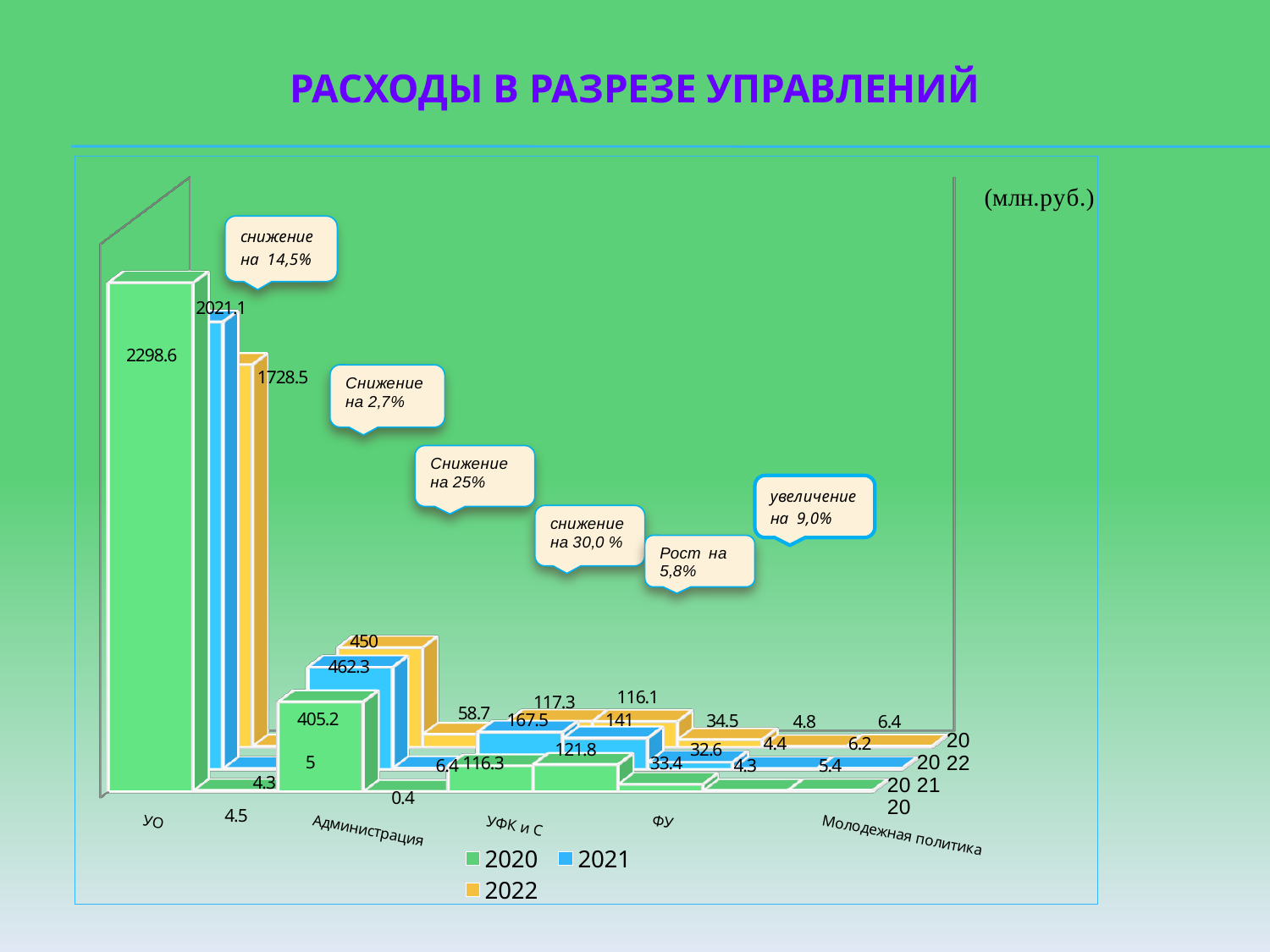
Which is larger for Администрация: the 2020 value or the 2021 value? 2021 What is the value for Администрация in 2022? 450 What is the difference between the УО values for 2020 and 2021? 277.5 What is the title of the chart? РАСХОДЫ В РАЗРЕЗЕ УПРАВЛЕНИЙ What is the value for Администрация in 2021? 462.3 What type of chart is shown on the slide? bar chart How many series does the legend list? 3 Which category has the highest expenses in 2020? УО What is the value for УО in 2020? 2298.6 What is the value for УО in 2022? 1728.5 What is the value for УО in 2021? 2021.1 What unit of measurement is indicated on the chart? млн.руб.